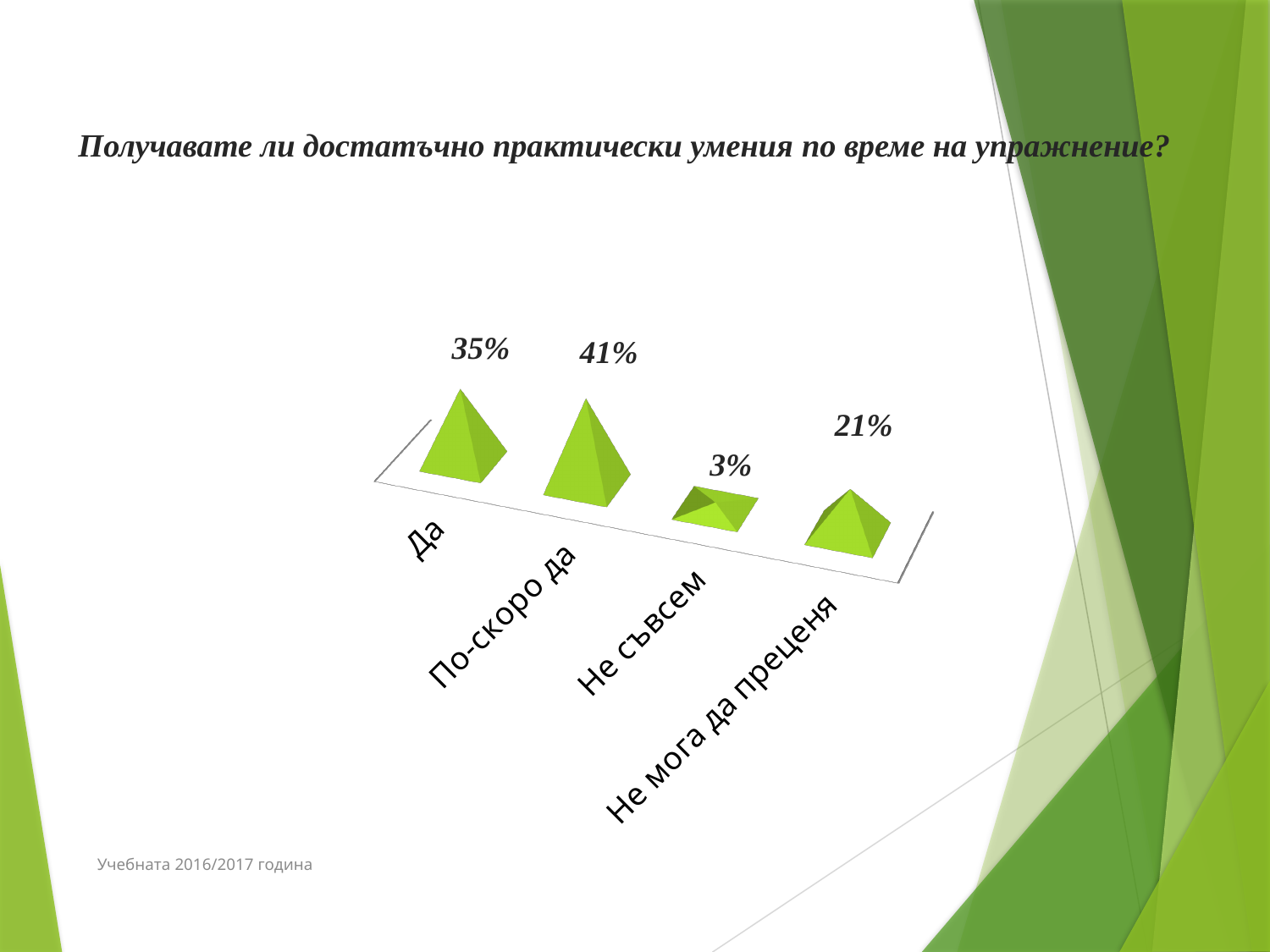
What kind of chart is shown on the slide? Bar chart What is the value for "Не съвсем"? 3% What is the value for "По-скоро да"? 41% What is the title of the chart? Получавате ли достатъчно практически умения по време на упражнение? What is the value for "Да"? 35% Which is larger, the value for "Да" or the value for "Не мога да преценя"? Да What is the difference between the values for "Не мога да преценя" and "Не съвсем"? 18% Which category has the highest value? По-скоро да What is the value for "Не мога да преценя"? 21% How many categories are shown in the chart? 4 What is the difference between the values for "По-скоро да" and "Да"? 6% Which category has the lowest value? Не съвсем